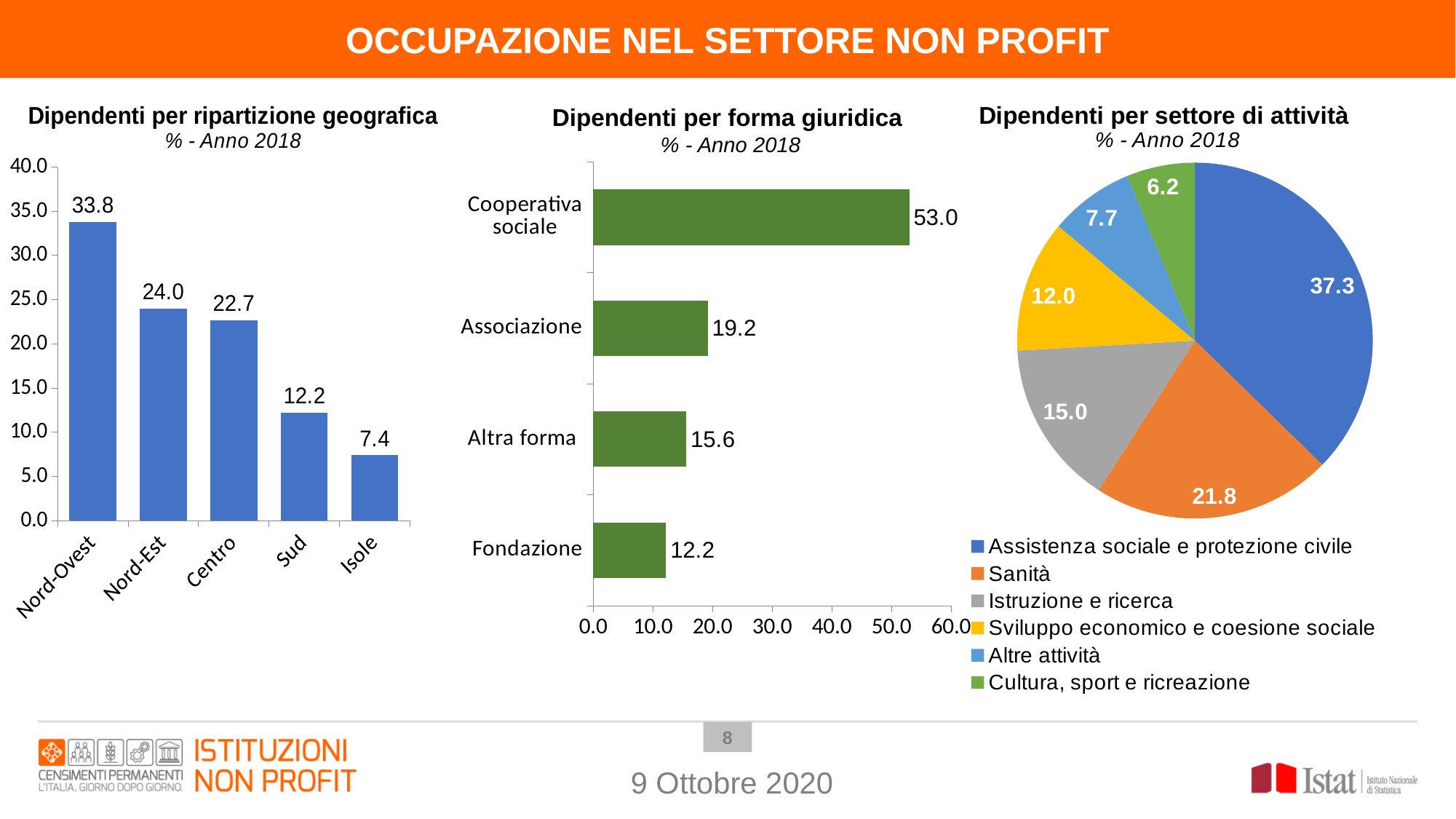
In the 'Dipendenti per forma giuridica' chart, which category has the highest value? Cooperativa sociale In the 'Dipendenti per ripartizione geografica' chart, how many categories are shown? 5 In the 'Dipendenti per settore di attività' pie chart, which sector has the smallest slice? Cultura, sport e ricreazione What kind of chart is 'Dipendenti per forma giuridica'? bar chart How many entries does the legend of the 'Dipendenti per settore di attività' chart list? 6 In the 'Dipendenti per settore di attività' pie chart, what is the value for Sanità? 21.8 In the 'Dipendenti per ripartizione geografica' chart, do the values rise or fall from Nord-Ovest to Isole? fall In the 'Dipendenti per ripartizione geografica' chart, which category has the lowest value? Isole In the 'Dipendenti per forma giuridica' chart, what is the value for Associazione? 19.2 In the 'Dipendenti per ripartizione geografica' chart, what is the value for Nord-Est? 24.0 In the 'Dipendenti per ripartizione geografica' chart, what is the difference between Nord-Ovest and Centro? 11.1 In the 'Dipendenti per forma giuridica' chart, which is larger, Altra forma or Fondazione? Altra forma